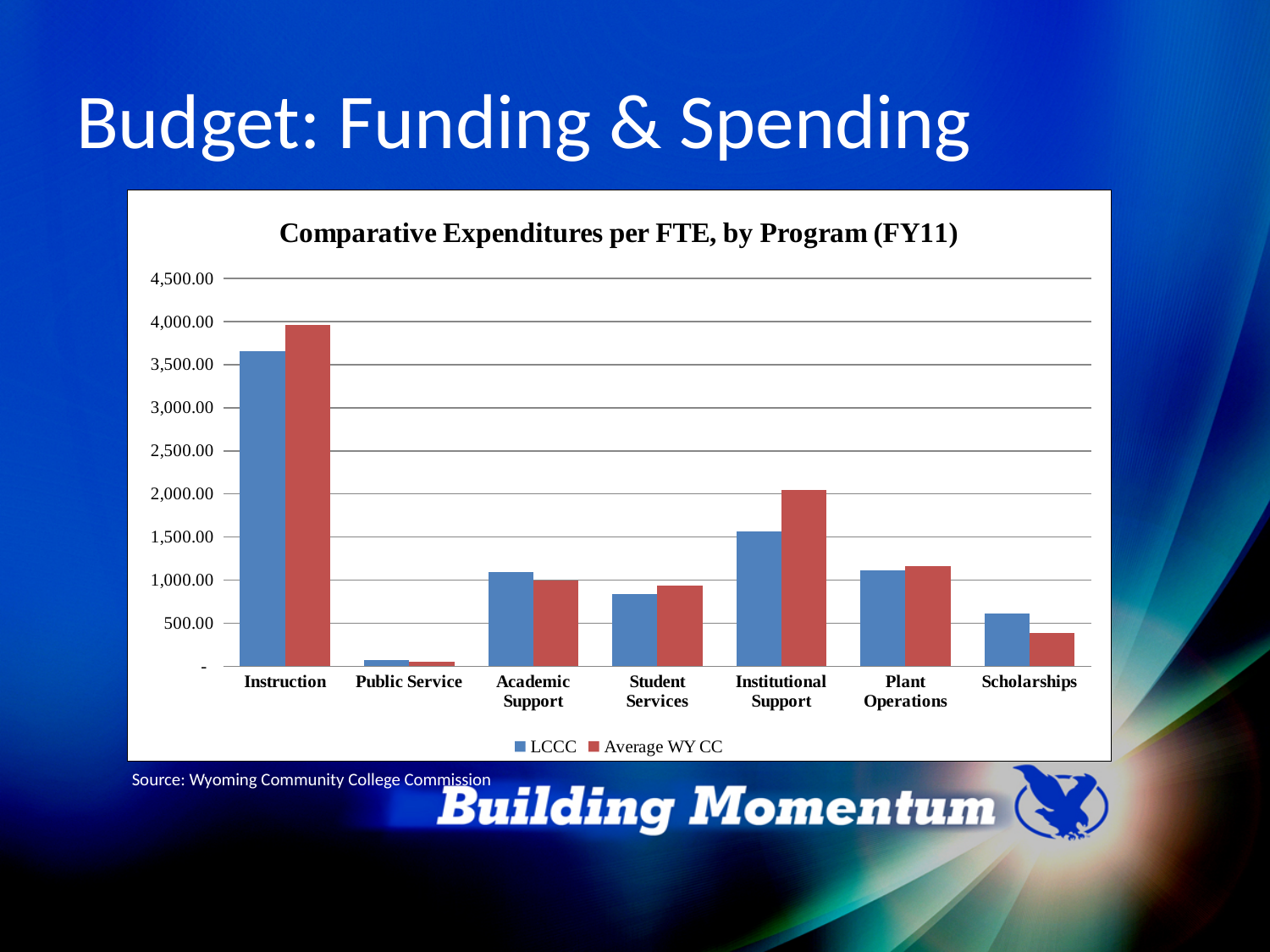
Is the LCCC value for Instruction greater or less than 3,500.00? greater Which program has the highest expenditure per FTE for LCCC? Instruction Which program has the lowest expenditure per FTE for Average WY CC? Public Service For Scholarships, which is larger: LCCC or Average WY CC? LCCC For Institutional Support, which is larger: LCCC or Average WY CC? Average WY CC Is the Average WY CC value for Scholarships greater or less than 500.00? less For Instruction, which is larger: LCCC or Average WY CC? Average WY CC How many series does the legend list? 2 What kind of chart is shown on the slide? bar chart What is the title of the chart? Comparative Expenditures per FTE, by Program (FY11) How many program categories are shown on the x axis? 7 Is the Average WY CC value for Institutional Support greater or less than 1,500.00? greater